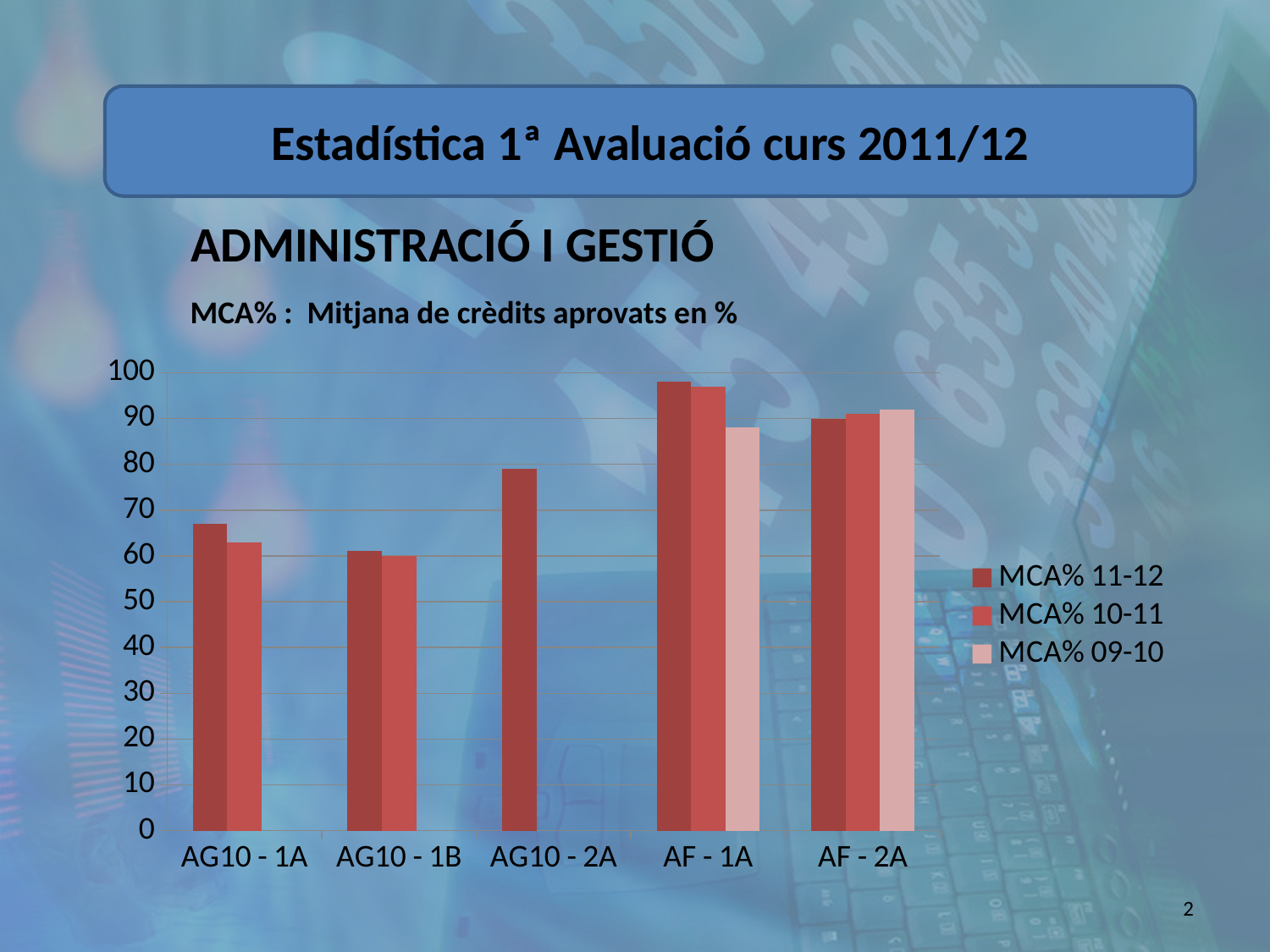
Is the MCA% 11-12 value for AF - 1A greater or less than 90? greater What kind of chart is shown on the slide? bar chart Which category on the chart has a bar for only one series? AG10 - 2A Which is larger for MCA% 11-12: AF - 1A or AF - 2A? AF - 1A Which category has the lowest MCA% 11-12 value? AG10 - 1B Which category has the highest MCA% 11-12 value? AF - 1A For AF - 1A, which is larger: MCA% 11-12 or MCA% 09-10? MCA% 11-12 Is the MCA% 11-12 value for AG10 - 2A greater or less than 70? greater Is the MCA% 09-10 value for AF - 1A greater or less than 90? less How many categories are shown on the x axis of the chart? 5 How many series does the chart legend list? 3